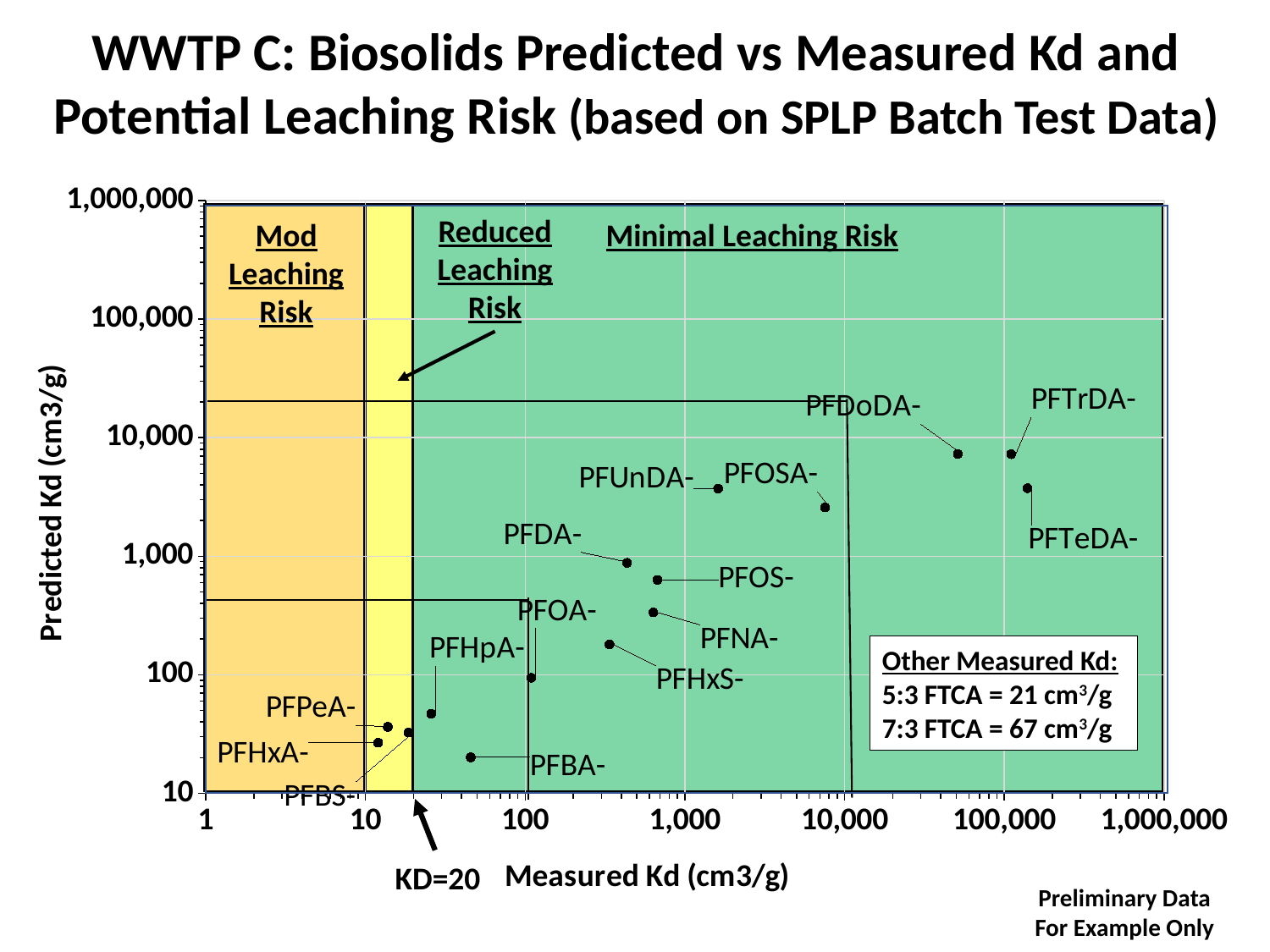
What Kd value does the arrow below the x axis mark as the boundary of the yellow zone? KD=20 Which has the larger measured Kd, PFOSA- or PFUnDA-? PFOSA- What is the label of the x axis of the chart? Measured Kd (cm3/g) Which has the larger measured Kd, PFBA- or PFOA-? PFOA- Is the predicted Kd for PFOA- greater or less than 1,000? less What kind of chart is shown on the slide? Scatter plot Is the predicted Kd for PFOSA- greater or less than 10,000? less Is the predicted Kd for PFDA- greater or less than 100? greater According to the text box on the chart, what is the measured Kd for 5:3 FTCA? 21 cm3/g How many compounds are plotted as points on the chart? 15